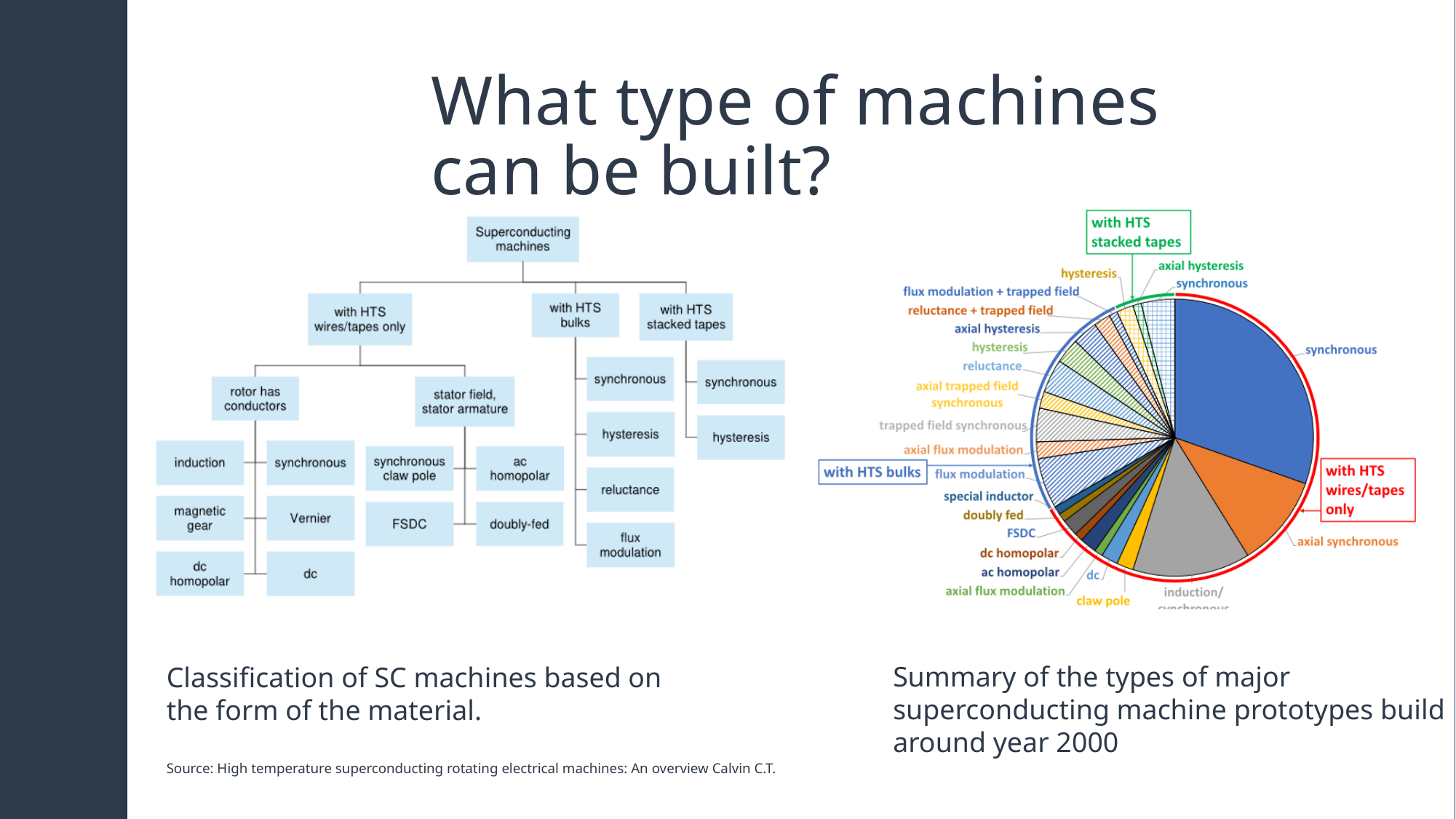
In the pie chart on the right, which slice is the largest? synchronous What kind of chart is the chart on the right of the slide? pie chart In the pie chart on the right, which group of machines is outlined in green? with HTS stacked tapes In the pie chart on the right, which group of machines is outlined in red? with HTS wires/tapes only In the pie chart on the right, which slice is larger: synchronous or induction/synchronous? synchronous In the pie chart on the right, which slice is larger: synchronous or axial synchronous? synchronous In the pie chart on the right, which slice is larger: induction/synchronous or dc? induction/synchronous